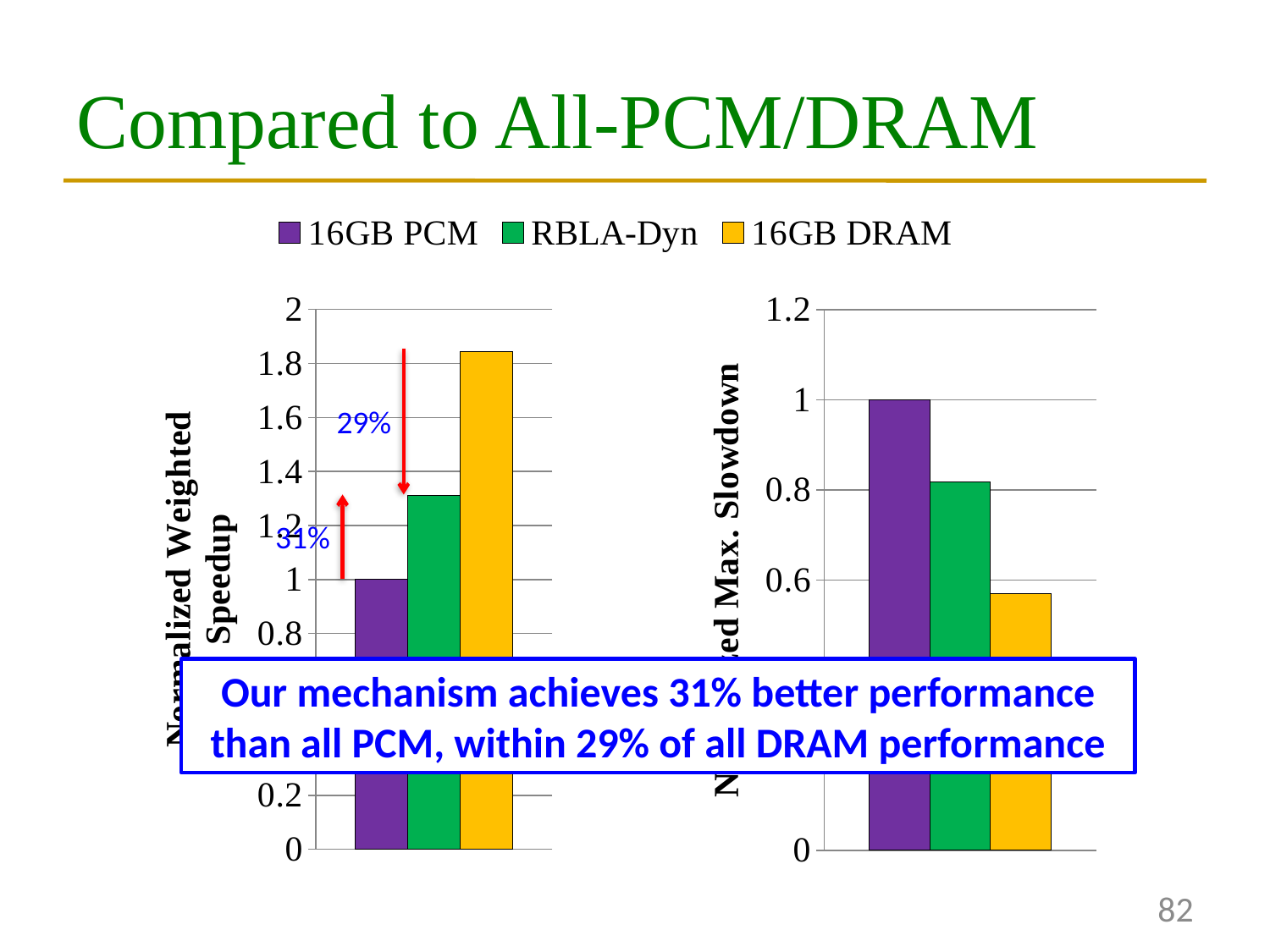
In the left chart (Normalized Weighted Speedup), which is larger, RBLA-Dyn or 16GB DRAM? 16GB DRAM How many series does the legend list? 3 What kind of chart is the left chart (Normalized Weighted Speedup)? bar chart In the left chart (Normalized Weighted Speedup), which series has the highest bar? 16GB DRAM In the left chart (Normalized Weighted Speedup), is the value for RBLA-Dyn greater or less than 1.2? greater In the right chart (Normalized Max. Slowdown), is the value for 16GB DRAM greater or less than 0.8? less In the right chart (Normalized Max. Slowdown), which series has the lowest bar? 16GB DRAM In the right chart (Normalized Max. Slowdown), which series has the highest bar? 16GB PCM In the left chart (Normalized Weighted Speedup), what is the value for 16GB PCM? 1 In the left chart (Normalized Weighted Speedup), which series has the lowest bar? 16GB PCM In the left chart (Normalized Weighted Speedup), is the value for 16GB DRAM greater or less than 1.6? greater In the right chart (Normalized Max. Slowdown), what is the value for 16GB PCM? 1